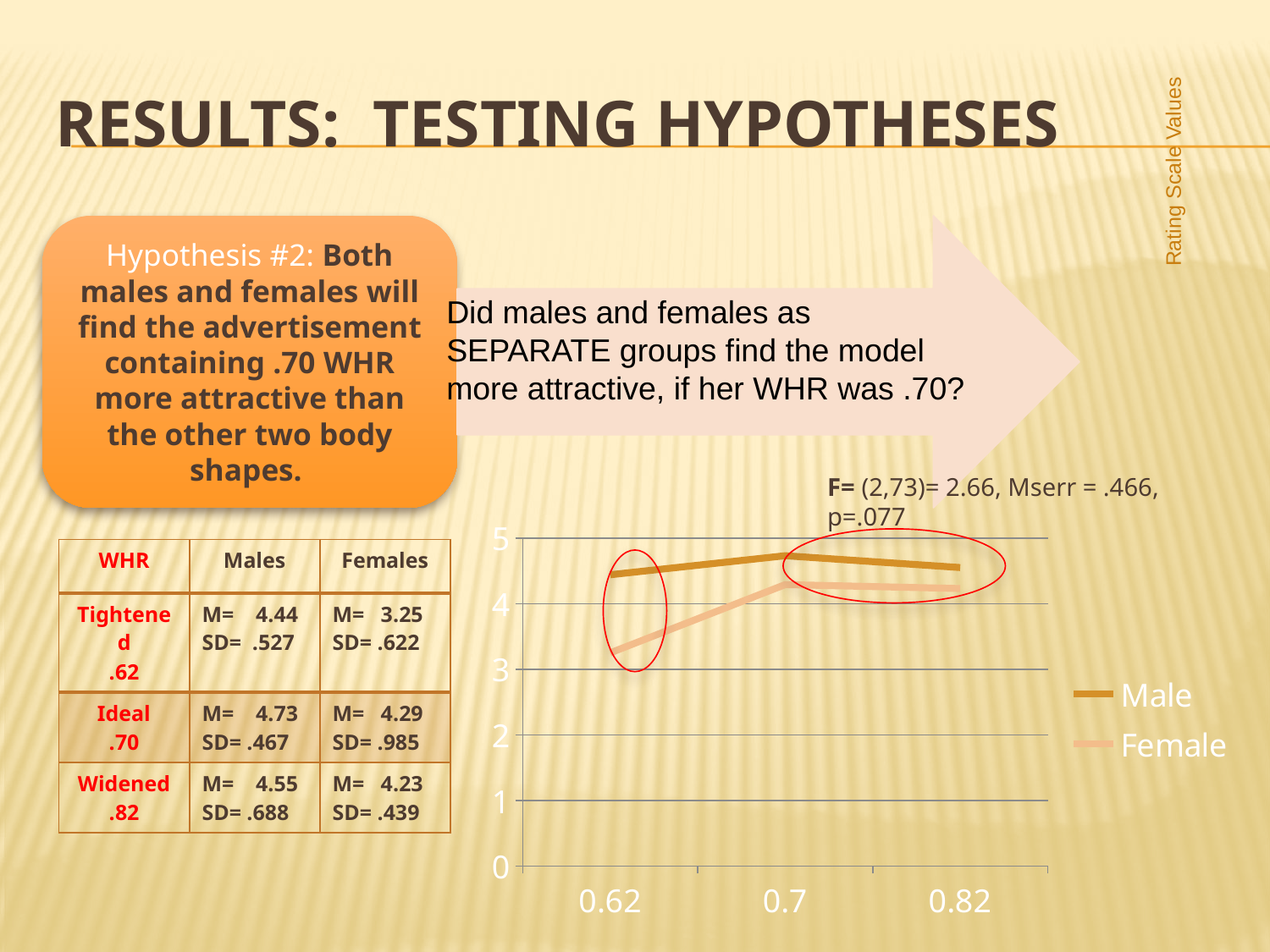
According to the table on the slide, what is the mean Male rating for the Ideal .70 WHR plotted in the chart? 4.73 What are the two series named in the chart legend? Male and Female Is the Male value at WHR 0.62 greater or less than 4? greater What kind of chart is shown on the slide? line chart Does the Female line rise or fall from WHR 0.62 to 0.7? rise How many WHR values are plotted along the x axis of the chart? 3 Is the Female value at WHR 0.82 greater or less than 4? greater Is the Male value at WHR 0.7 greater or less than 5? less At which WHR value is the Female rating lowest? 0.62 How many series does the chart legend list? 2 At WHR 0.62, which series has the higher rating, Male or Female? Male